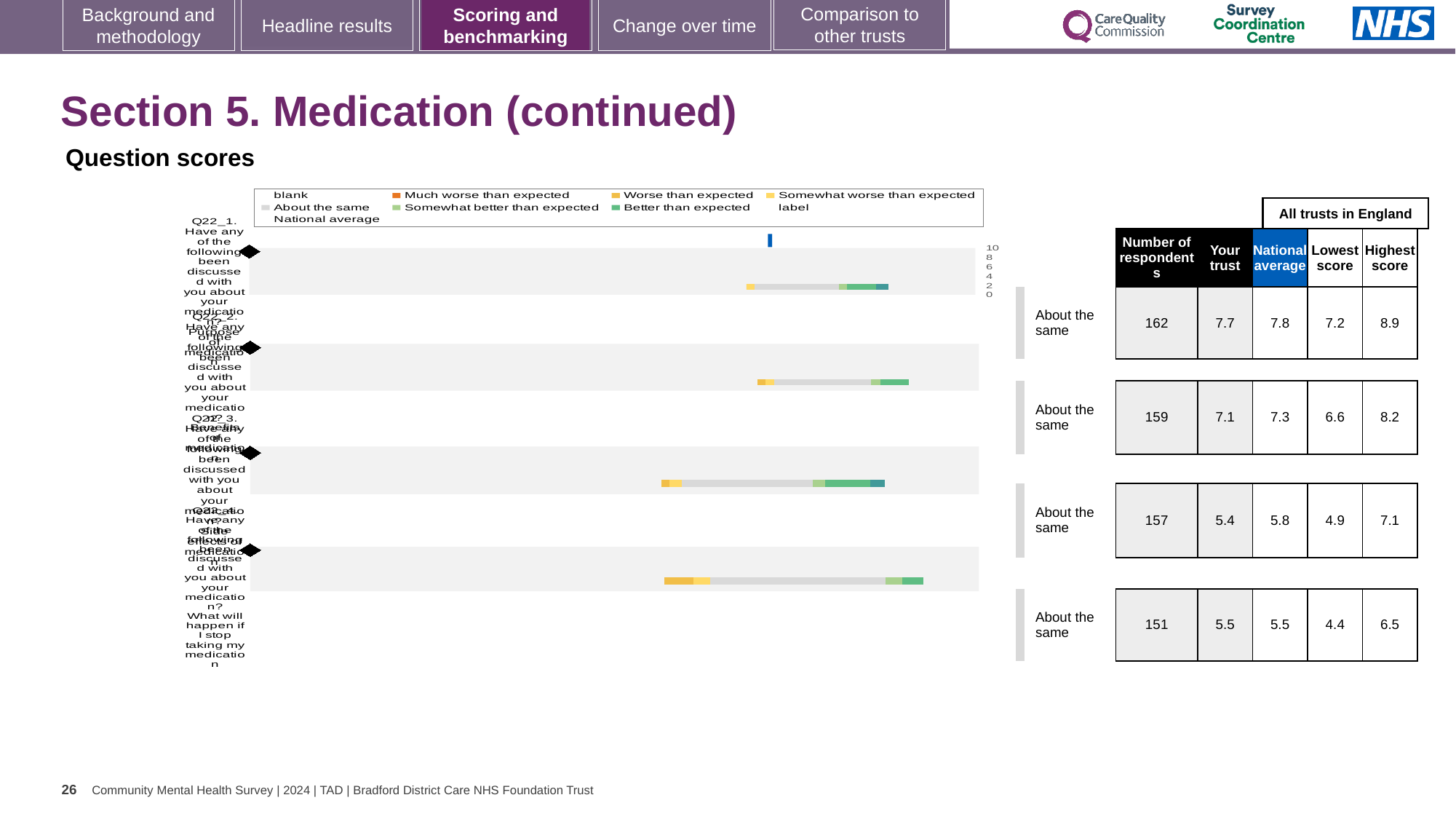
For the third question row (Q22_3), which is larger: the 'Your trust' score or the national average? National average What benchmark category is shown next to every question bar? About the same Which question row has the highest 'Your trust' score? Q22_1 (first row) What is the 'Your trust' score for the last question row, 'What will happen if I stop taking my medication'? 5.5 What is the lowest score across all trusts in England for the last question row (Q22_4)? 4.4 How many entries does the chart legend list? 9 What kind of chart is shown under 'Question scores'? bar chart What is the highest score across all trusts in England for the third question row (Q22_3)? 7.1 What is the highest value shown on the chart's axis? 10 What is the difference between the national average and the 'Your trust' score for the second question row (Q22_2)? 0.2 How many respondents are listed for the first question row (Q22_1)? 162 How many question bars are plotted in the chart? 4